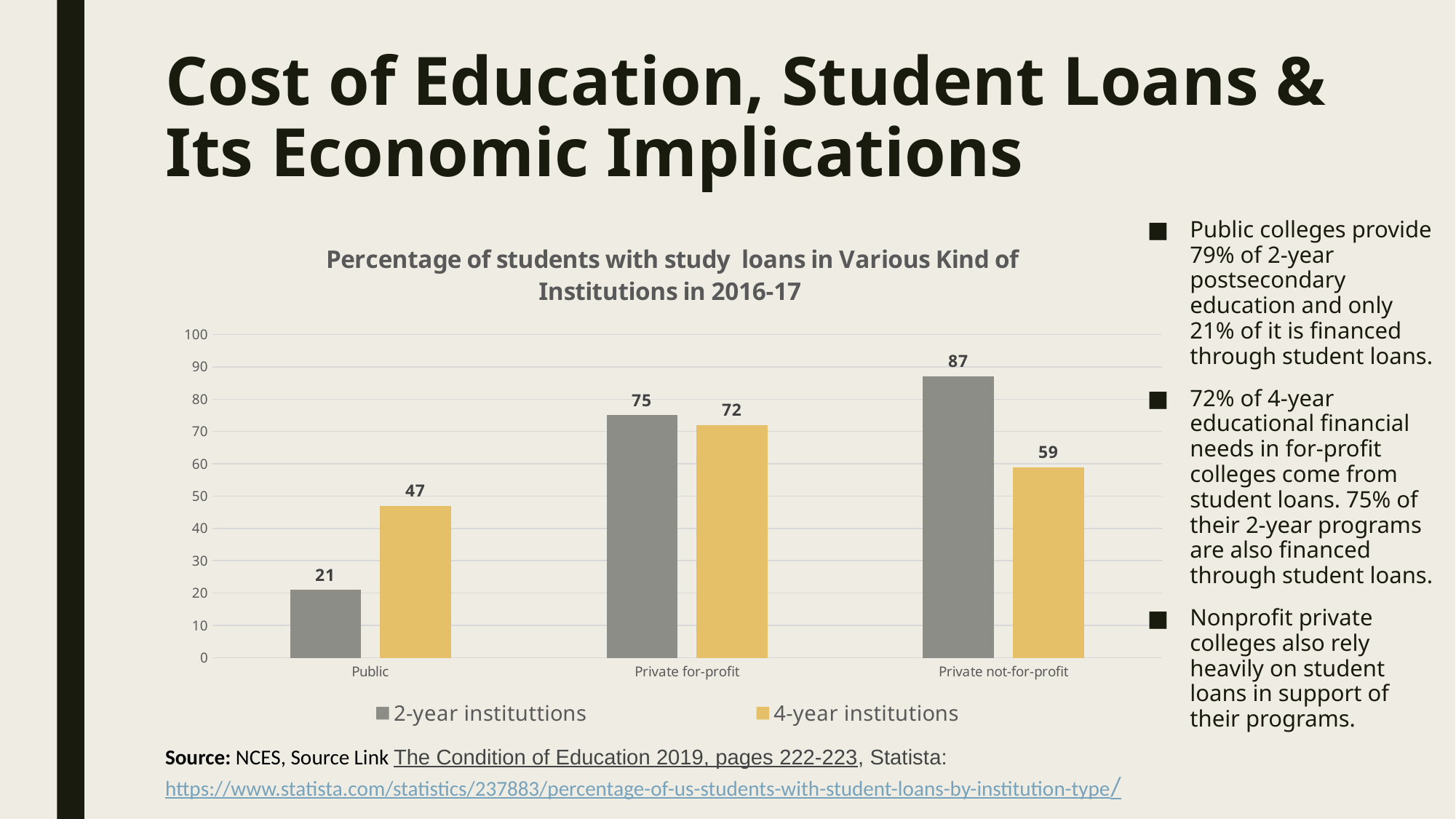
How many series does the legend list? 2 What is the value for 4-year institutions in the Private not-for-profit category? 59 Which category has the lowest value for 4-year institutions? Public How many categories are shown on the x axis? 3 What kind of chart is shown on the slide? Bar chart In the Public category, which is larger: the value for 2-year institutions or 4-year institutions? 4-year institutions Which category has the highest value for 2-year institutions? Private not-for-profit What is the value for 4-year institutions in the Private for-profit category? 72 Is the value for 2-year institutions in the Private for-profit category greater or less than 70? greater What is the value for 2-year institutions in the Public category? 21 What colour represents 4-year institutions in the chart? Yellow What is the difference between the 2-year and 4-year institution values in the Private not-for-profit category? 28